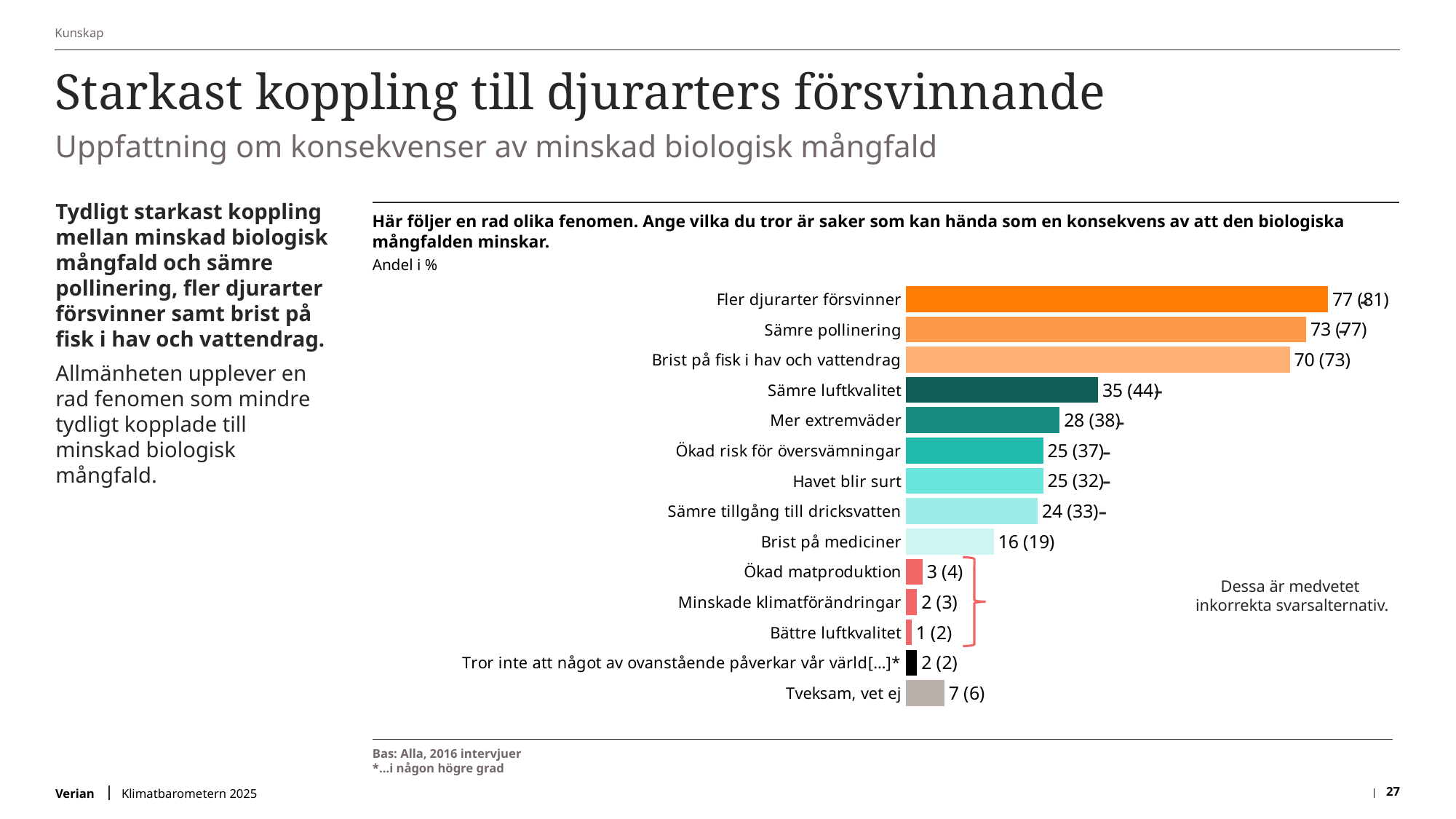
What is the data label shown for "Sämre luftkvalitet"? 35 (44) What is the data label shown for "Fler djurarter försvinner"? 77 (81) What kind of chart is shown on the slide? bar chart Which category has the longest bar? Fler djurarter försvinner Which has a longer bar, "Brist på fisk i hav och vattendrag" or "Sämre luftkvalitet"? Brist på fisk i hav och vattendrag Using the first number in each label, what is the difference between "Sämre luftkvalitet" and "Mer extremväder"? 7 Using the first number in each label, what is the difference between "Fler djurarter försvinner" and "Sämre pollinering"? 4 What is the data label shown for "Tveksam, vet ej"? 7 (6) Which category has the shortest bar? Bättre luftkvalitet What unit is stated for the values in the chart? Andel i % How many categories (bars) are shown in the chart? 14 What is the data label shown for "Brist på mediciner"? 16 (19)